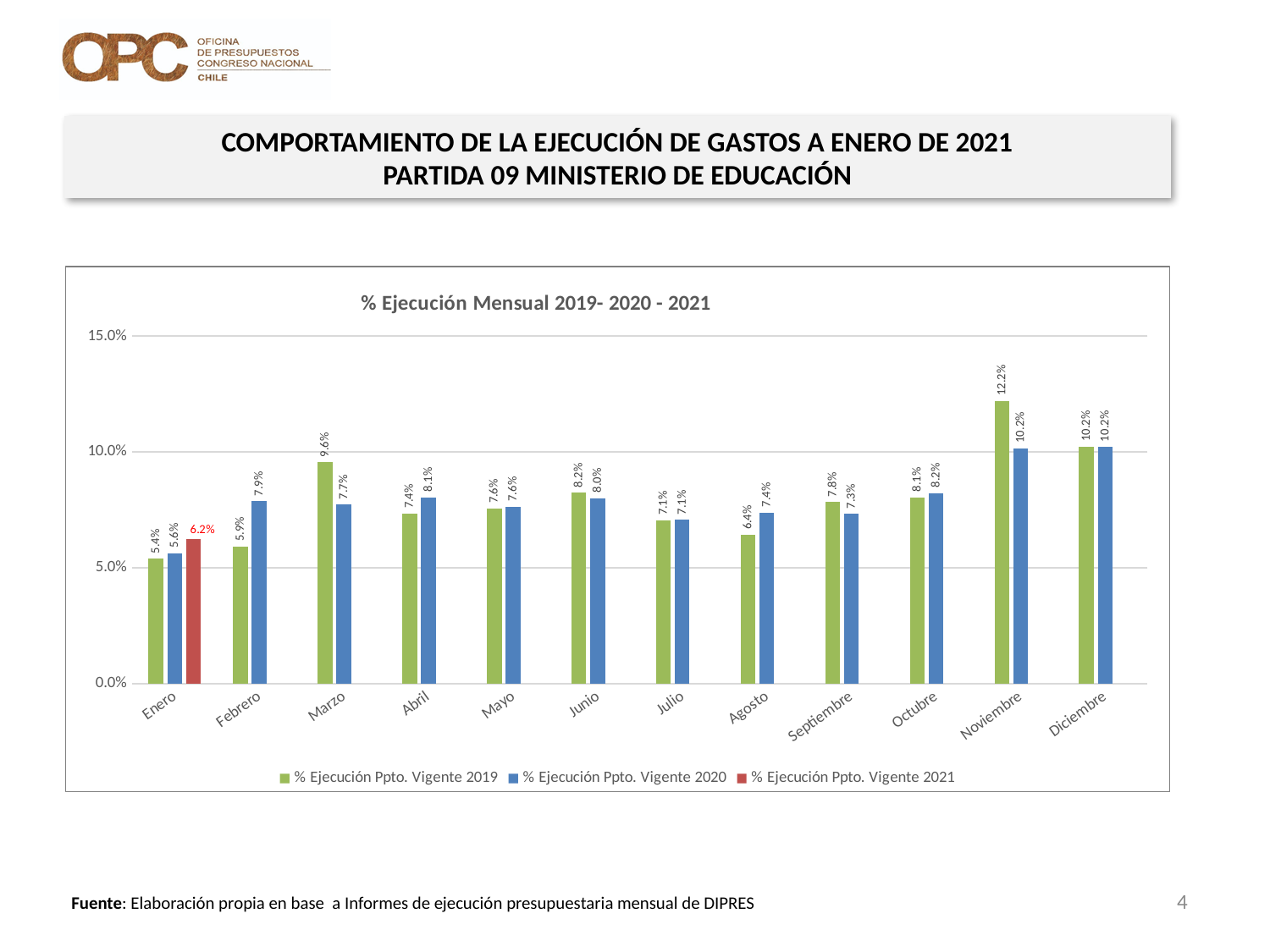
How many months are shown on the x axis? 12 What is the value of % Ejecución Ppto. Vigente 2021 for Enero? 6.2% How many series does the legend list? 3 For Febrero, which is larger: the 2019 value or the 2020 value? 2020 What is the value of % Ejecución Ppto. Vigente 2020 for Noviembre? 10.2% Is the value of % Ejecución Ppto. Vigente 2019 for Noviembre greater or less than 10.0%? greater What is the title of the chart? % Ejecución Mensual 2019- 2020 - 2021 Which month has the lowest value for % Ejecución Ppto. Vigente 2020? Enero Which month has the highest value for % Ejecución Ppto. Vigente 2019? Noviembre What type of chart is shown on the slide? Bar chart What is the value of % Ejecución Ppto. Vigente 2019 for Marzo? 9.6% What is the difference between the 2019 and 2020 values for Noviembre? 2.0%